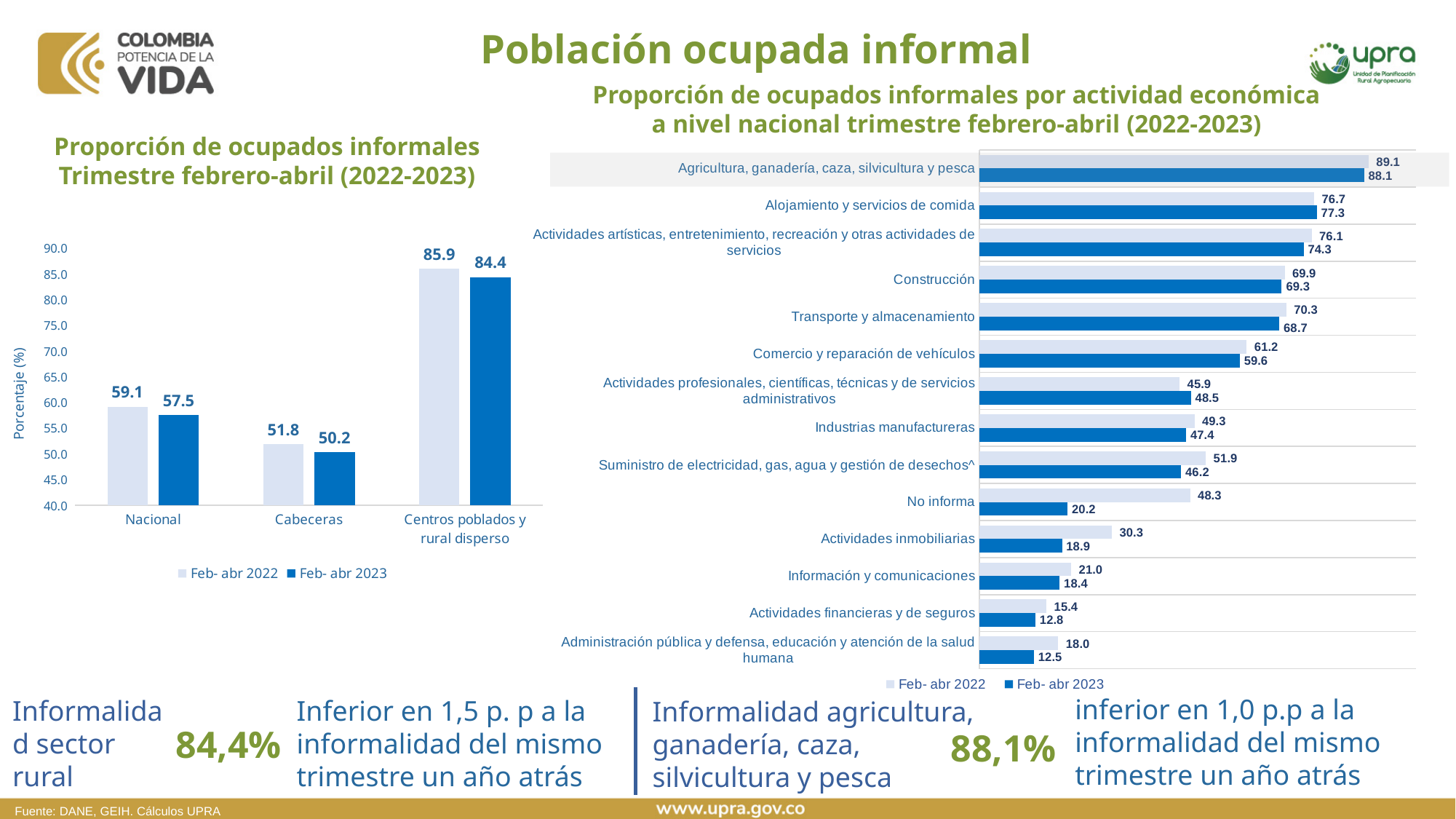
In the right chart (Proporción de ocupados informales por actividad económica), what is the difference between the Feb- abr 2022 and Feb- abr 2023 values for No informa? 28.1 In the left chart (Proporción de ocupados informales Trimestre febrero-abril), which category has the lowest value in Feb- abr 2023? Cabeceras In the right chart (Proporción de ocupados informales por actividad económica), which activity has the lowest value in Feb- abr 2023? Administración pública y defensa, educación y atención de la salud humana In the left chart (Proporción de ocupados informales Trimestre febrero-abril), what is the value for Centros poblados y rural disperso in Feb- abr 2023? 84.4 How many economic activities are shown in the right chart (Proporción de ocupados informales por actividad económica)? 14 In the right chart (Proporción de ocupados informales por actividad económica), which activity has the highest value in Feb- abr 2022? Agricultura, ganadería, caza, silvicultura y pesca In the right chart (Proporción de ocupados informales por actividad económica), what is the value for Construcción in Feb- abr 2023? 69.3 In the left chart (Proporción de ocupados informales Trimestre febrero-abril), how many series does the legend list? 2 What kind of chart is the left chart (Proporción de ocupados informales Trimestre febrero-abril)? Bar chart In the right chart (Proporción de ocupados informales por actividad económica), which is larger for Actividades profesionales, científicas, técnicas y de servicios administrativos: the Feb- abr 2022 value or the Feb- abr 2023 value? Feb- abr 2023 In the left chart (Proporción de ocupados informales Trimestre febrero-abril), what is the value for Cabeceras in Feb- abr 2022? 51.8 In the left chart (Proporción de ocupados informales Trimestre febrero-abril), what is the difference between the Nacional values for Feb- abr 2022 and Feb- abr 2023? 1.6